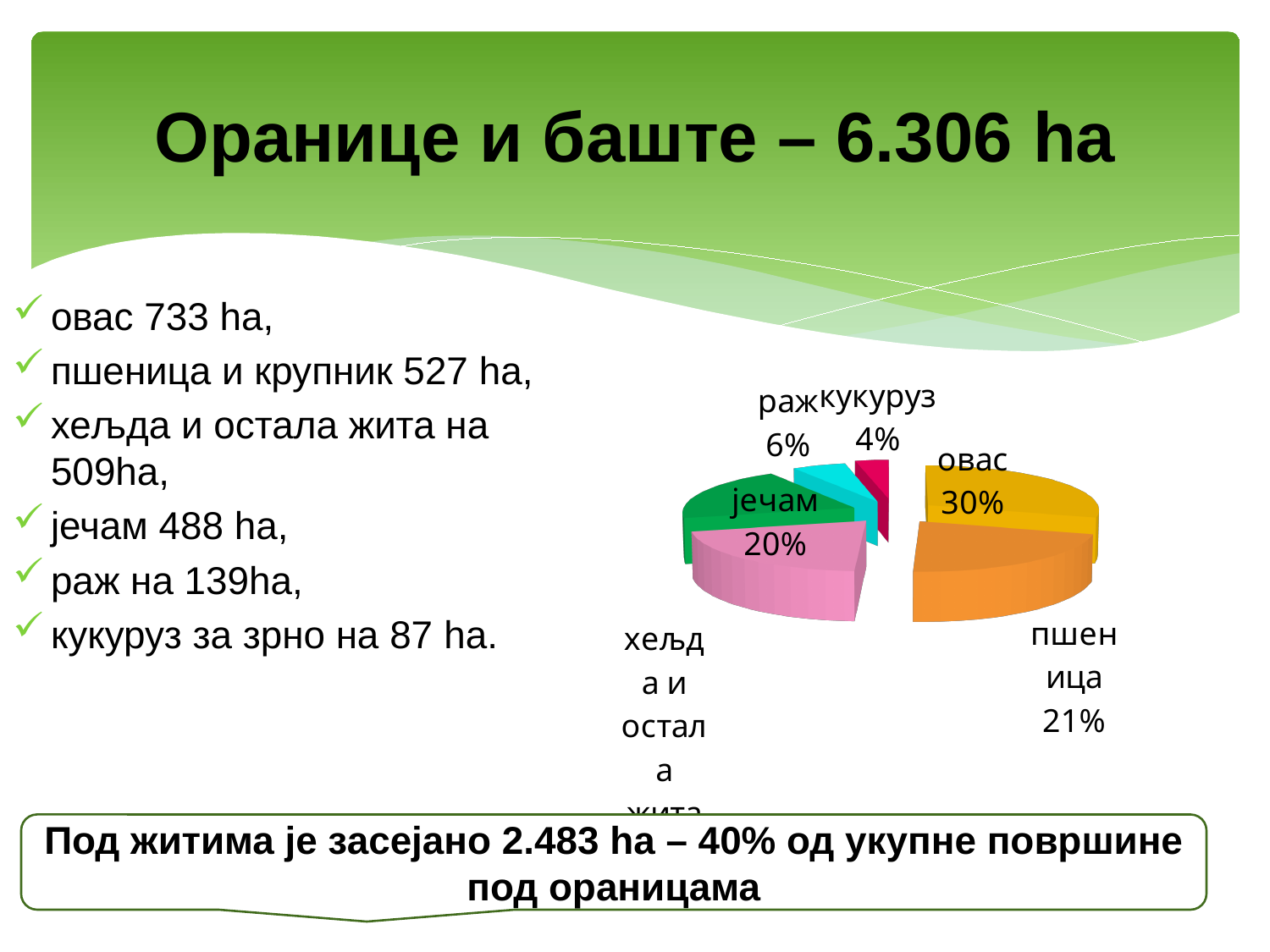
What share of the pie does пшеница have? 21% What share of the pie does раж have? 6% Which slice is larger, раж or кукуруз? раж Which slice of the pie is the largest? овас What share of the pie does кукуруз have? 4% How many slices does the pie chart have? 6 How many percentage points larger is the овас share than the пшеница share? 9 Which slice of the pie is the smallest? кукуруз What kind of chart is shown on the slide? pie chart What colour is the јечам slice of the pie? green